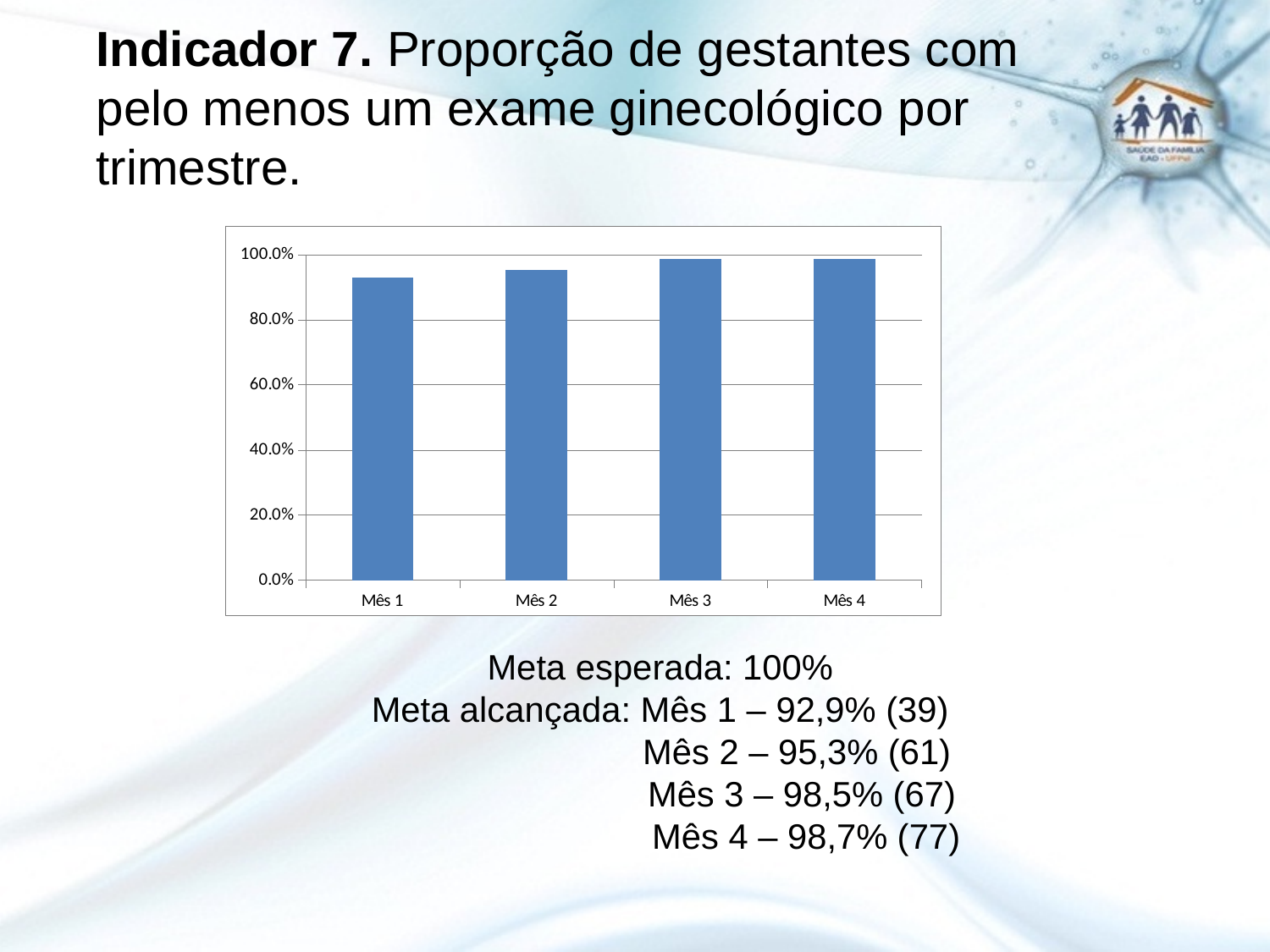
What colour are the bars in the chart? blue What type of chart is shown on the slide? bar chart Is the value for Mês 3 greater or less than 100.0%? less Do the values rise or fall from Mês 1 to Mês 4? rise Is the value for Mês 1 greater or less than 80.0%? greater Which is larger, the value for Mês 1 or the value for Mês 2? Mês 2 Which month has the lowest bar in the chart? Mês 1 According to the slide, what proportion was achieved in Mês 1? 92,9% What is the difference between the proportions achieved in Mês 2 and Mês 1, as given on the slide? 2,4% What is the expected target (meta esperada) stated on the slide? 100% How many months (categories) are plotted in the chart? 4 According to the slide, what proportion was achieved in Mês 4? 98,7%